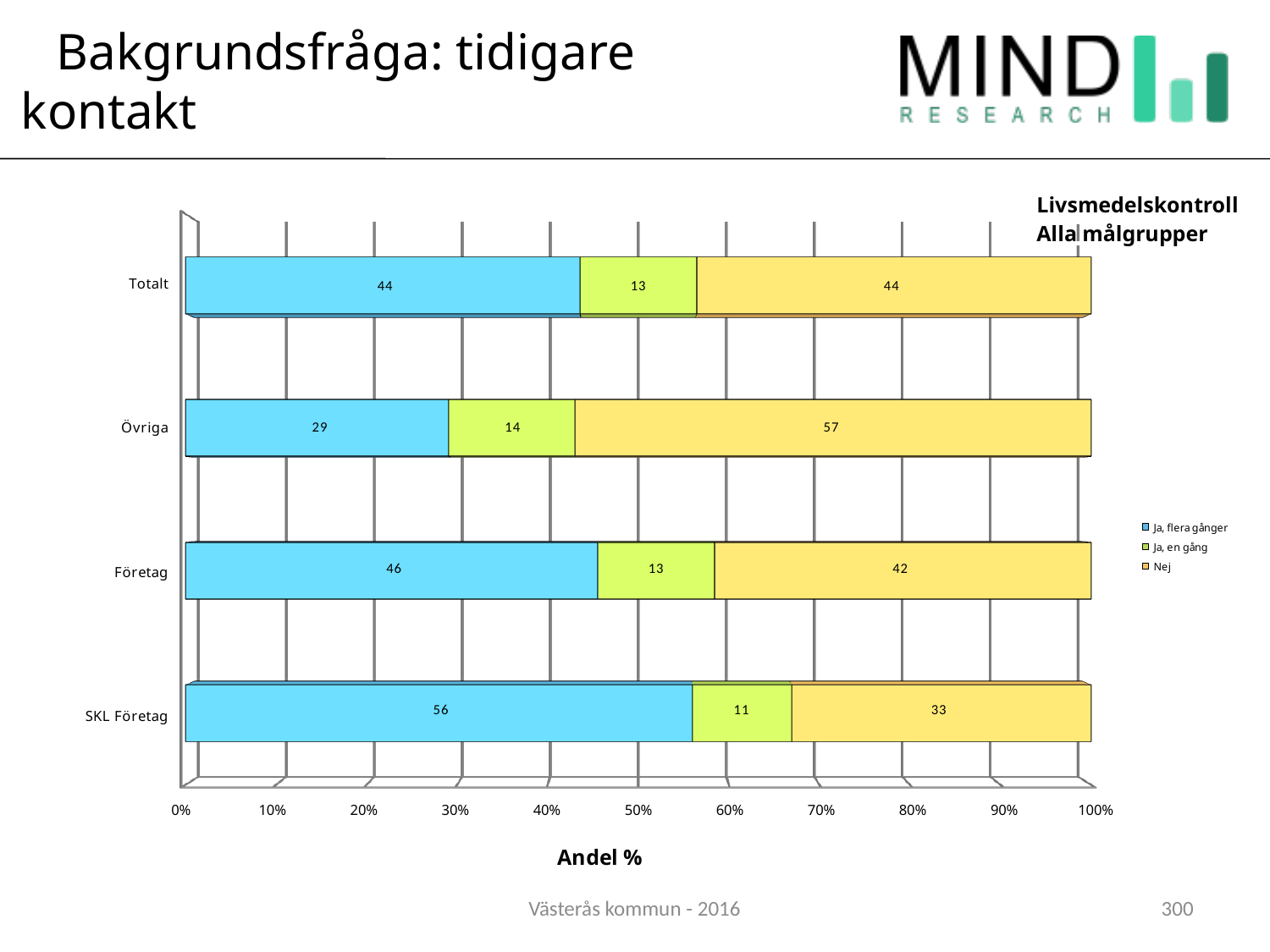
Which category has the lowest value for "Nej"? SKL Företag How many categories are shown on the vertical axis? 4 How many series does the legend list? 3 Which category has the highest value for "Ja, flera gånger"? SKL Företag What is the difference between the "Nej" values for Övriga and Företag? 15 What kind of chart is shown on the slide? Stacked bar chart What is the value for "Nej" in the Övriga bar? 57 What is the value for "Ja, flera gånger" in the SKL Företag bar? 56 What is the value for "Ja, en gång" in the Företag bar? 13 What is the total of the SKL Företag bar? 100 Which is larger: the "Ja, flera gånger" value for Företag or for Övriga? Företag What is the label of the horizontal axis? Andel %